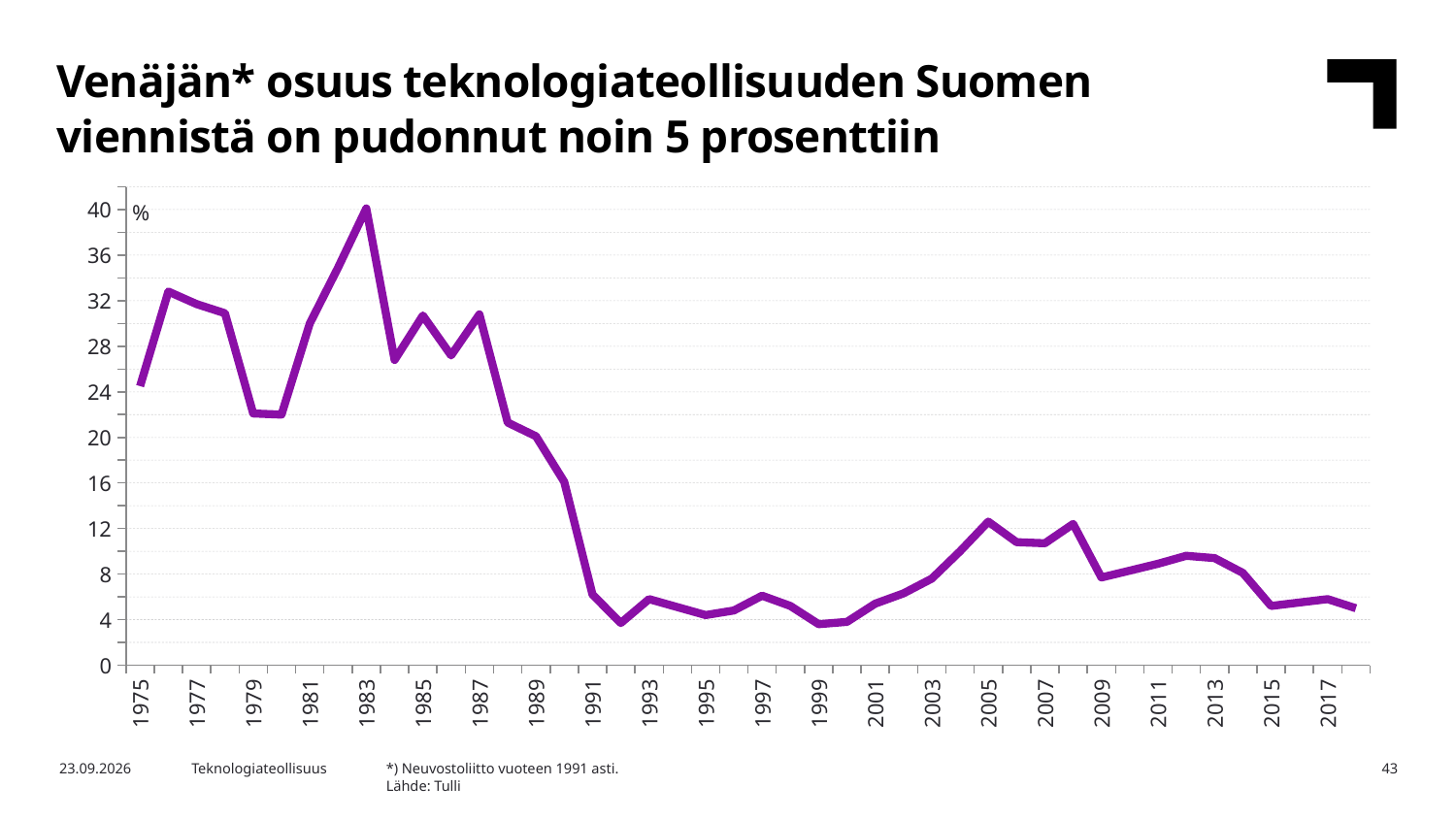
What kind of chart is shown on the slide? line chart Is the value for 1991 greater or less than 8? less Which year has the larger value, 1983 or 1985? 1983 Is the value for 1983 greater or less than 36? greater Is the value for 2018 greater or less than 8? less In which year does the line reach its highest value? 1983 Which year has the larger value, 1975 or 2018? 1975 Overall, does the line rise or fall from 1975 to 2018? fall Which year has the larger value, 1999 or 2005? 2005 What unit is shown on the vertical axis? %